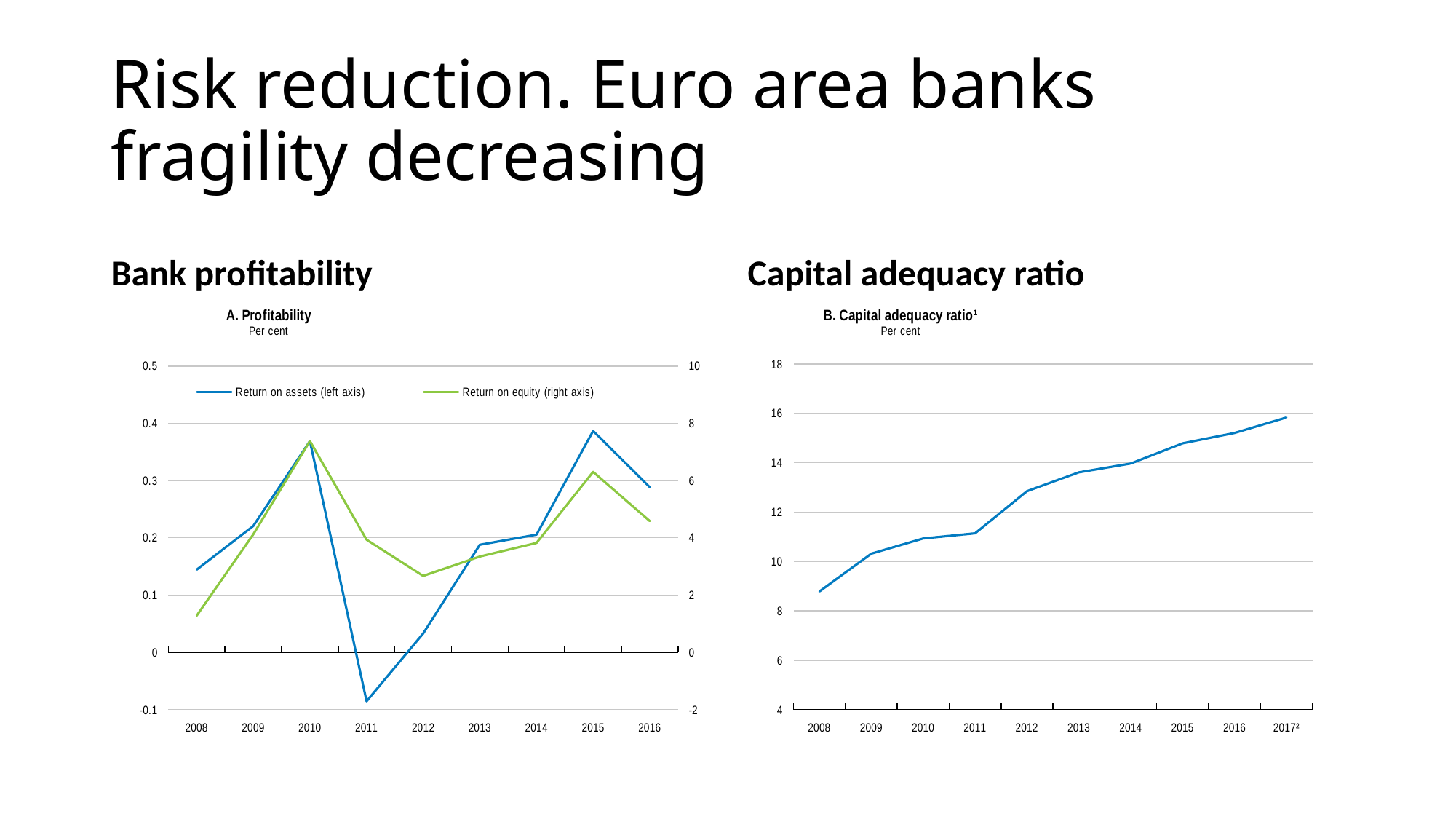
In the Capital adequacy ratio chart, is the value for 2008 greater or less than 10? less In the Capital adequacy ratio chart, do values generally rise or fall from 2008 to 2017? Rise In the Profitability chart, which year has the highest value for Return on equity? 2010 How many series does the legend of the Profitability chart list? 2 What type of chart is the Profitability chart on the left? Line chart In the Profitability chart, which axis does the Return on equity series use? Right axis In the Profitability chart, is the value for Return on equity in 2010 greater or less than 6? greater How many years are plotted on the x axis of the Capital adequacy ratio chart? 10 In the Profitability chart, is the value for Return on assets in 2011 greater or less than 0? less In the Profitability chart, which is larger: Return on assets in 2016 or in 2014? 2016 In the Capital adequacy ratio chart, which year has the highest value? 2017 In the Profitability chart, which year has the lowest value for Return on assets? 2011